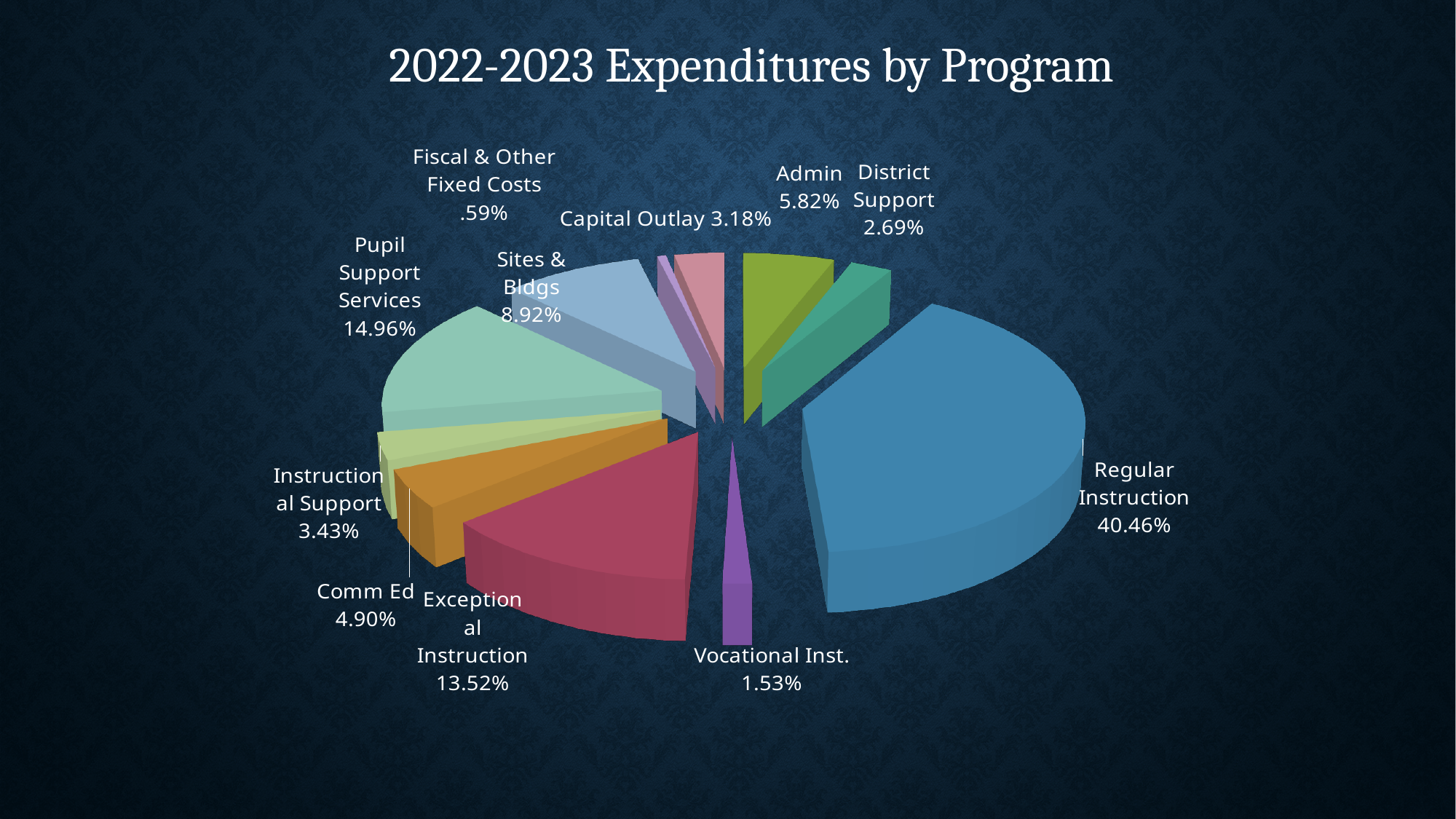
What type of chart is shown on the slide? Pie chart What share of expenditures is Sites & Bldgs? 8.92% How many program categories are shown in the pie chart? 11 What is the value shown for Pupil Support Services? 14.96% What is the title of the chart? 2022-2023 Expenditures by Program What percentage of expenditures goes to Regular Instruction? 40.46% What is the difference in percentage points between Capital Outlay and District Support? 0.49 What percentage is shown for Vocational Inst.? 1.53% Which program has the smallest share of expenditures? Fiscal & Other Fixed Costs Which is larger, Admin or Comm Ed? Admin What is the difference in percentage points between Pupil Support Services and Exceptional Instruction? 1.44 Which program has the largest share of expenditures? Regular Instruction